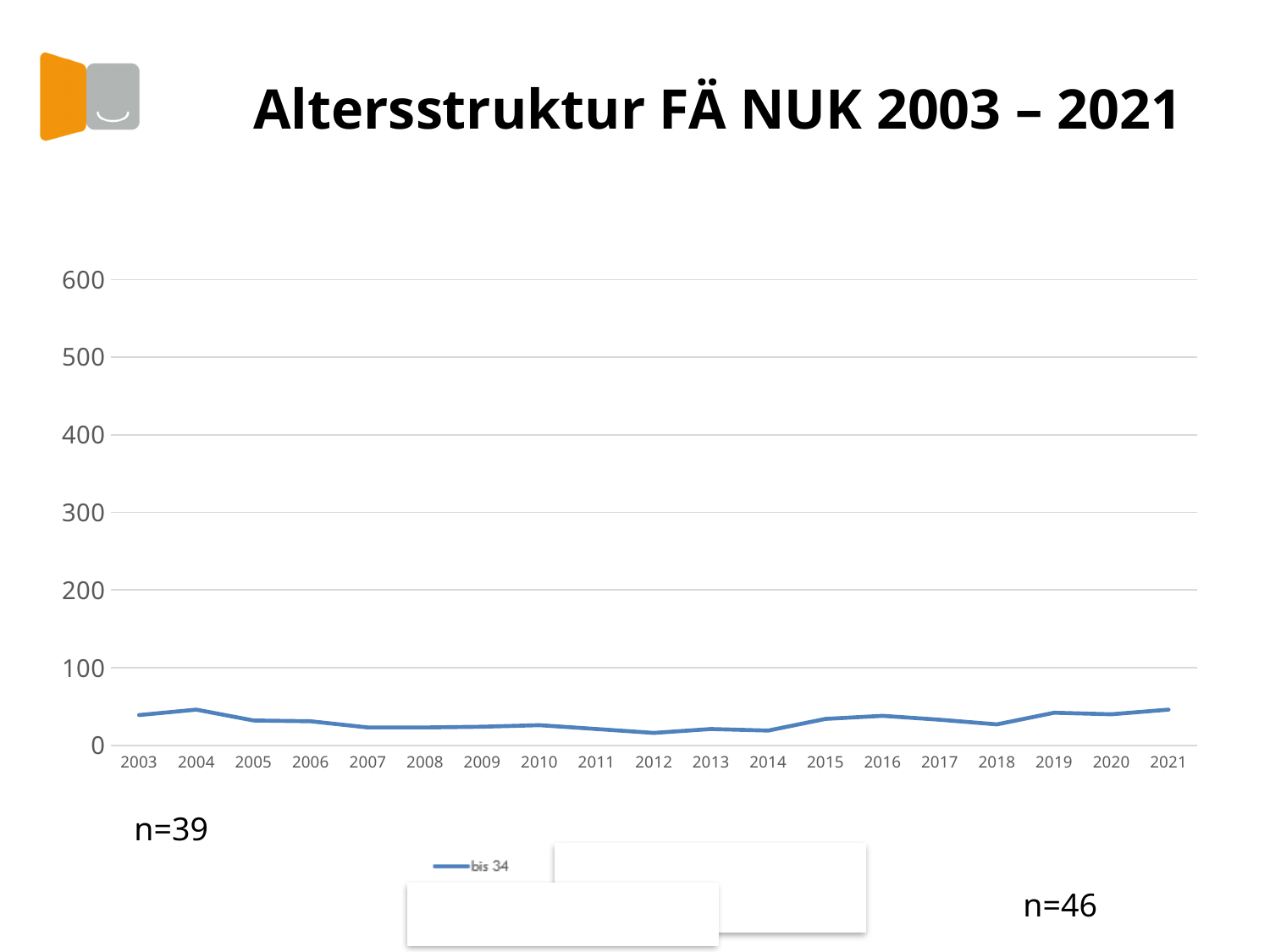
Is the value for 2012 greater or less than 100? less What kind of chart is shown on the slide? line chart Does the 'bis 34' series rise or fall between 2012 and 2016? rise What is the name of the series shown in the legend? bis 34 How many years are plotted along the x axis? 19 Which is larger, the value for 2004 or the value for 2012? 2004 What is the first year shown on the x axis? 2003 Is the value for 2004 greater or less than 100? less Which year has the lowest value for the 'bis 34' series? 2012 Which is larger, the value for 2021 or the value for 2014? 2021 What is the title of the chart on the slide? Altersstruktur FÄ NUK 2003 – 2021 How many series does the legend list? 1